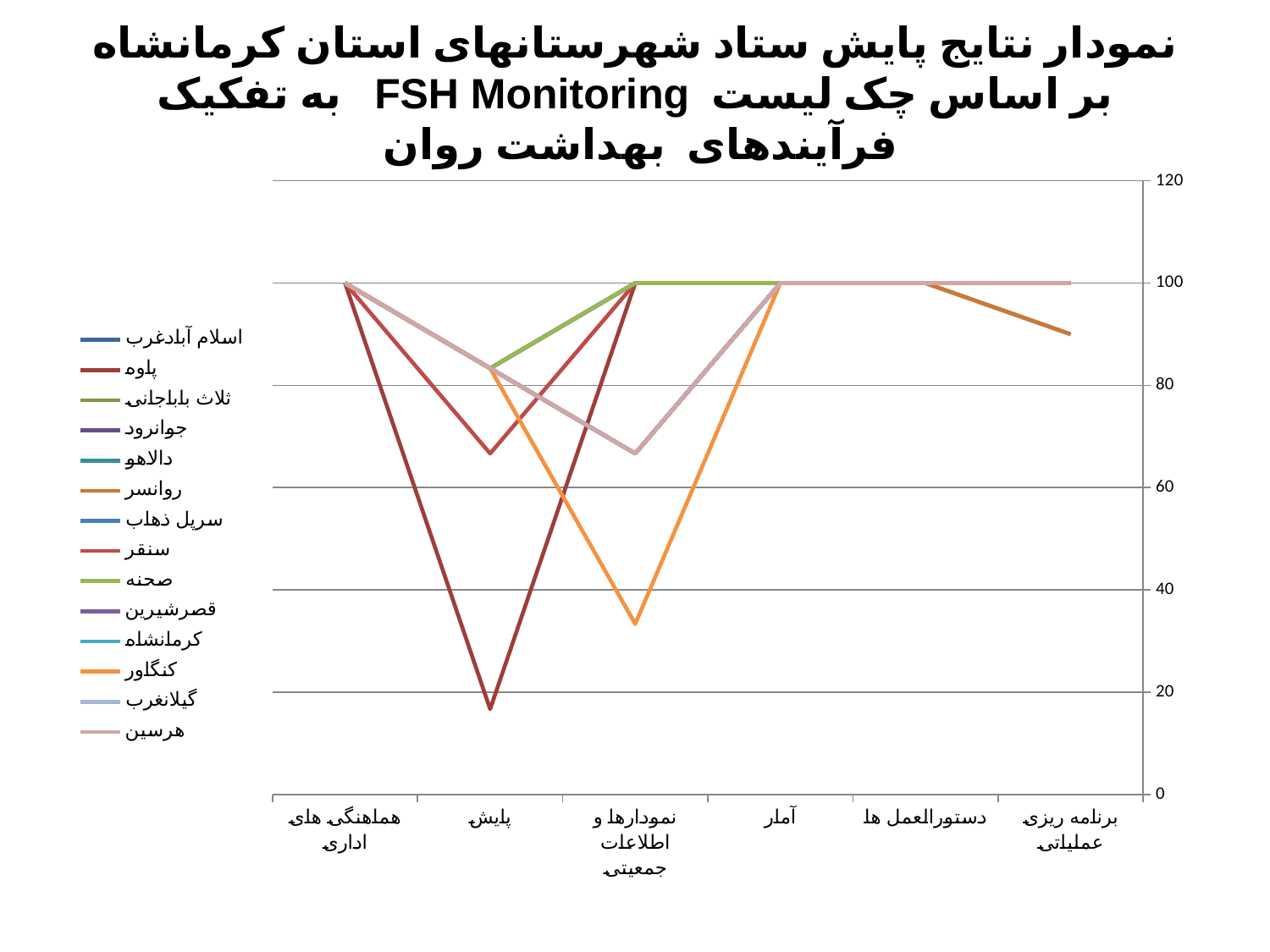
How many categories are shown along the x axis of the chart? 6 What value do all the series share at the category دستورالعمل ها? 100 Which category on the x axis contains the lowest plotted value in the chart? پایش Is the lowest value plotted at برنامه ریزی عملیاتی greater or less than 80? greater Is the value for کنگاور at نمودارها و اطلاعات جمعیتی greater or less than 40? less What kind of chart is shown on the slide? line chart What is the highest value shown on the chart's y axis? 120 Which is the first category listed on the x axis (leftmost)? هماهنگی های اداری Is the lowest value plotted at نمودارها و اطلاعات جمعیتی greater or less than 40? less How many series does the chart's legend list? 14 What value do all the series share at the category آمار? 100